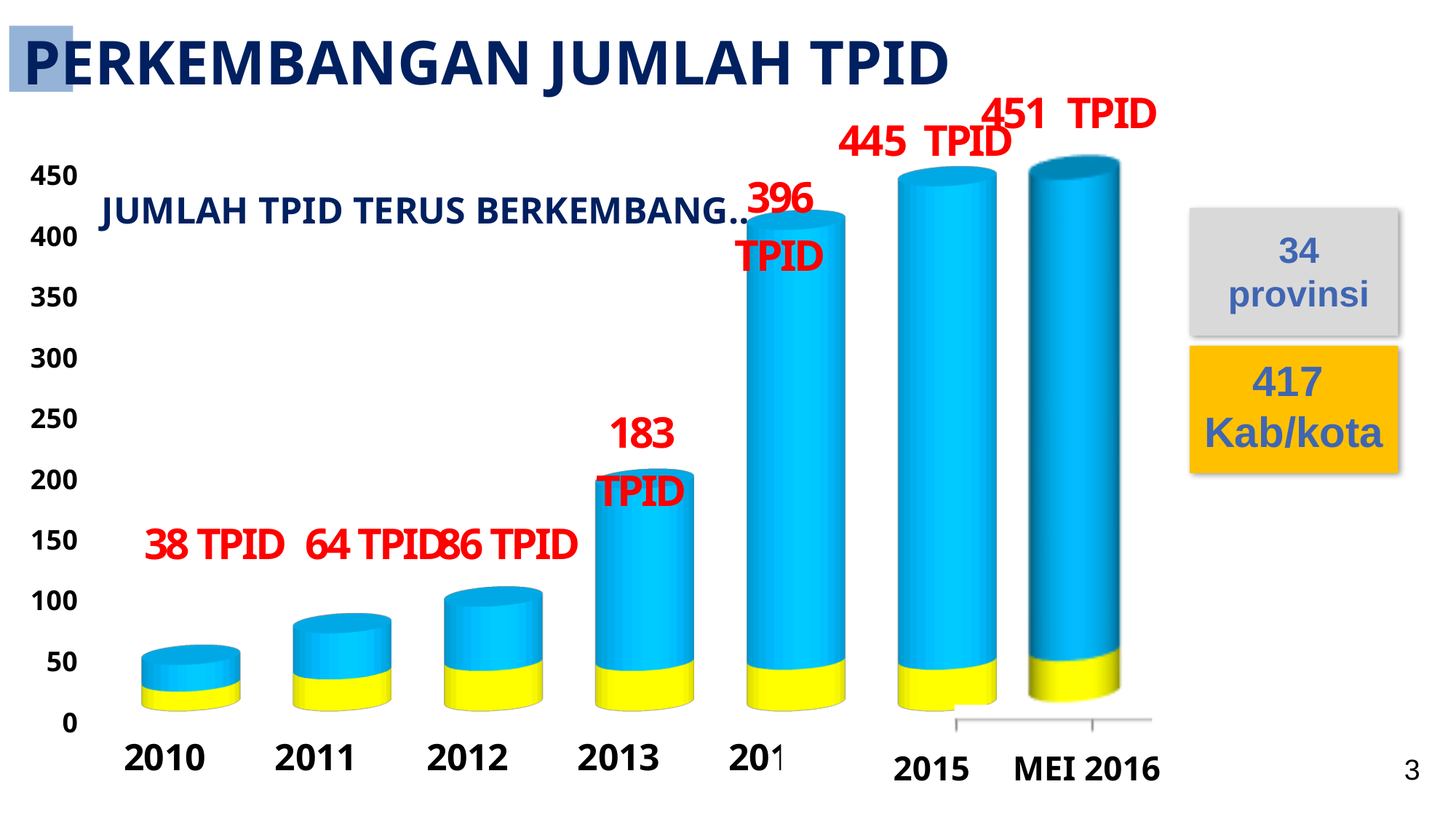
Which is larger, the value for 2013 or the value for 2012? 2013 Which category has the lowest value? 2010 Do the values rise or fall from 2010 to MEI 2016? rise What is the difference between the values for 2012 and 2011? 22 How many categories are shown on the x axis? 7 What is the value for 2015? 445 TPID Which category has the highest value? MEI 2016 What is the value for 2010? 38 TPID What kind of chart is shown on the slide? bar chart What is the value for 2013? 183 TPID What is the difference between the values for MEI 2016 and 2015? 6 What is the value for MEI 2016? 451 TPID